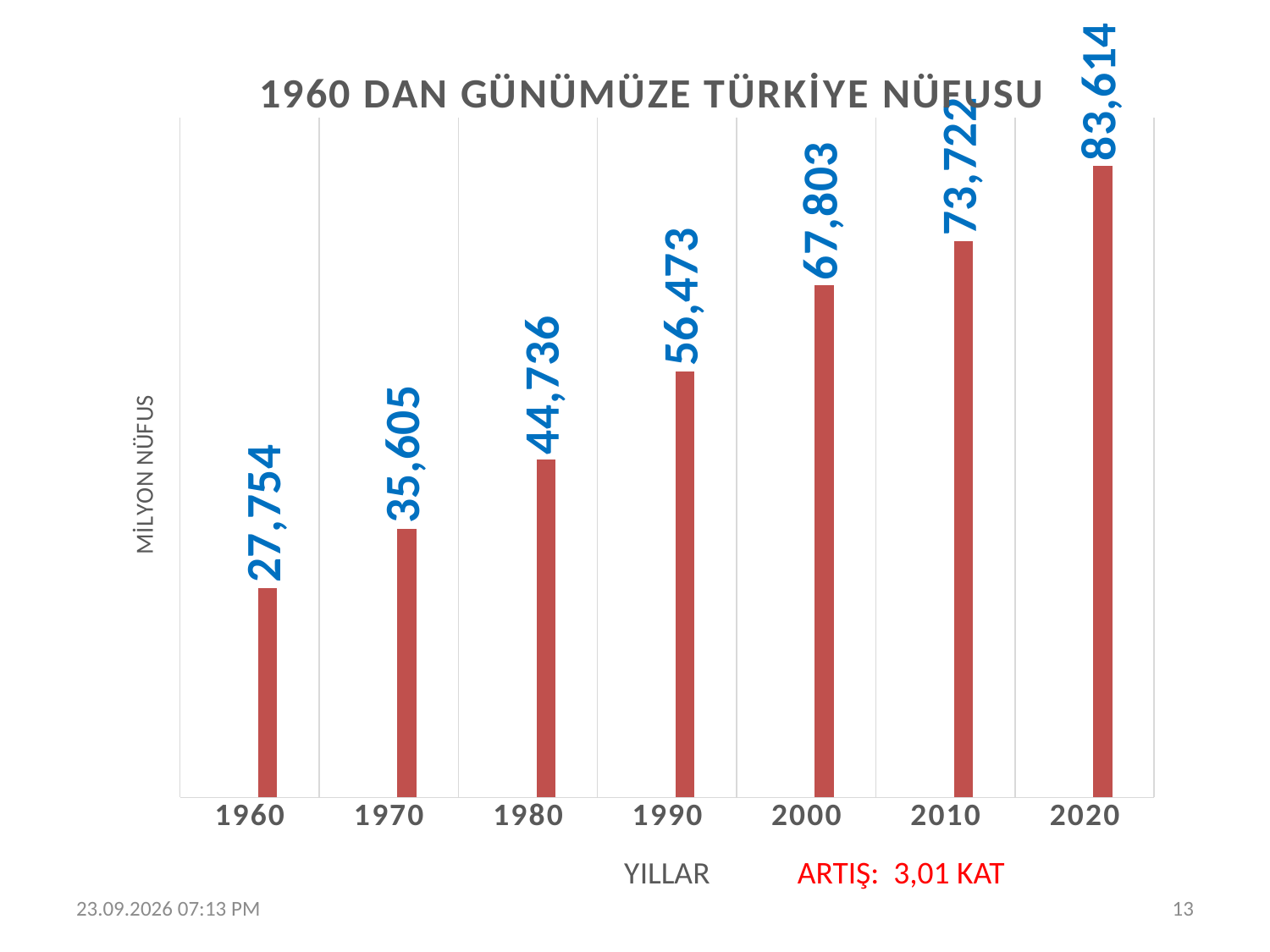
What kind of chart is this? Bar chart What is the difference between the values for 2020 and 1960? 55,860 Which year has the highest population value? 2020 Do the values rise or fall from 1960 to 2020? Rise Which is larger, the value for 1980 or the value for 1970? 1980 What is the population value shown for 1990? 56,473 What is the population value shown for 2000? 67,803 What is the difference between the values for 2010 and 2000? 5,919 What is the population value shown for 1960? 27,754 How many years are shown on the x axis? 7 What is the population value shown for 2020? 83,614 Which year has the lowest population value? 1960